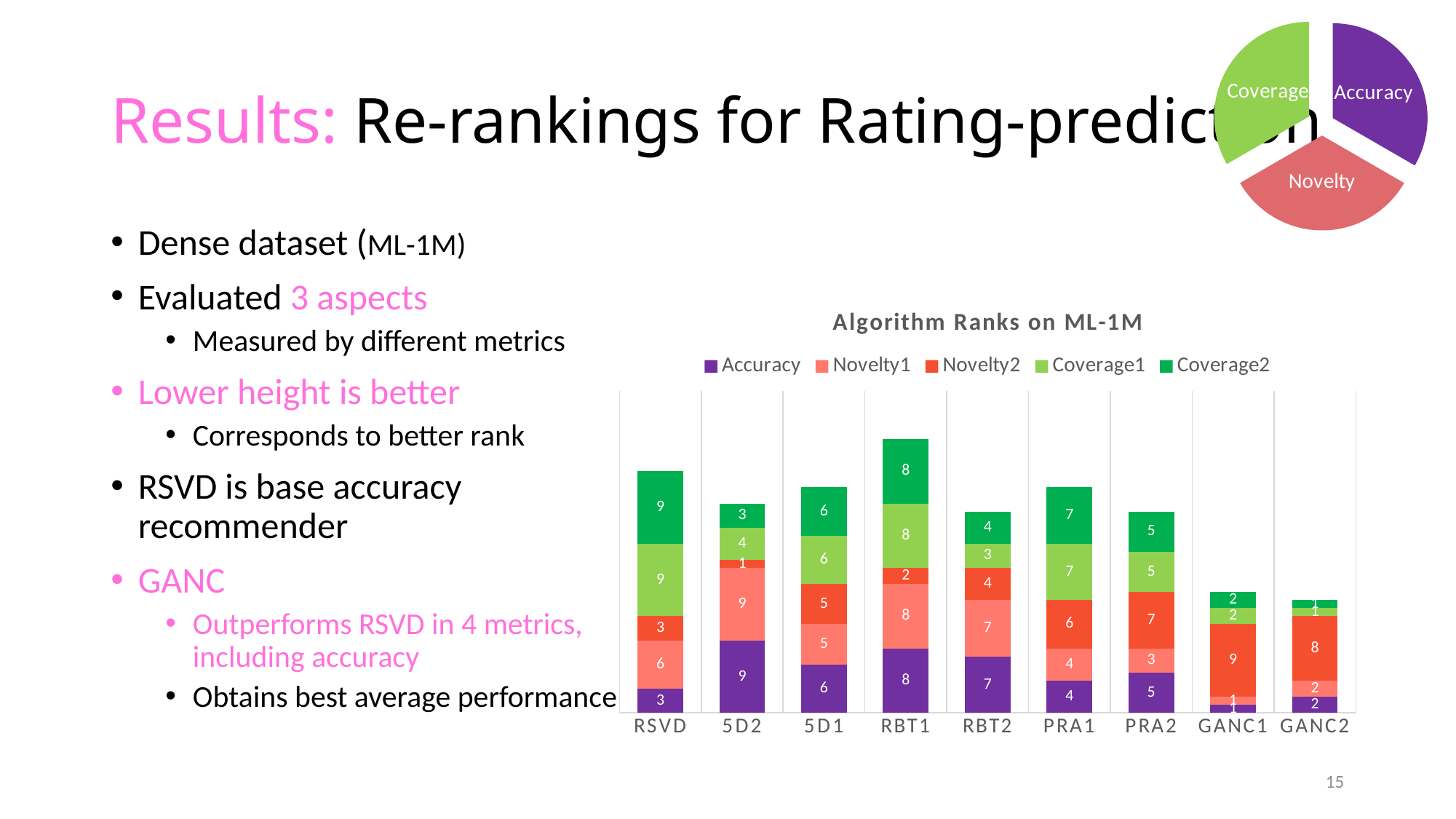
In 'Algorithm Ranks on ML-1M', what is the Coverage2 rank for RBT1? 8 In 'Algorithm Ranks on ML-1M', what is the total stacked height for RBT1? 34 What type of chart is 'Algorithm Ranks on ML-1M'? stacked bar chart How many series does the legend of 'Algorithm Ranks on ML-1M' list? 5 In 'Algorithm Ranks on ML-1M', what is the Novelty2 rank for GANC1? 9 In 'Algorithm Ranks on ML-1M', which is larger: the Coverage1 rank for PRA1 or for PRA2? PRA1 In 'Algorithm Ranks on ML-1M', what is the Accuracy rank for RSVD? 3 In 'Algorithm Ranks on ML-1M', what is the Novelty1 rank for 5D2? 9 How many algorithms are shown on the x axis of 'Algorithm Ranks on ML-1M'? 9 In 'Algorithm Ranks on ML-1M', what is the difference between the Accuracy ranks of 5D2 and RSVD? 6 In 'Algorithm Ranks on ML-1M', what is the total stacked height for RSVD? 30 In 'Algorithm Ranks on ML-1M', which algorithm has the tallest stacked bar? RBT1